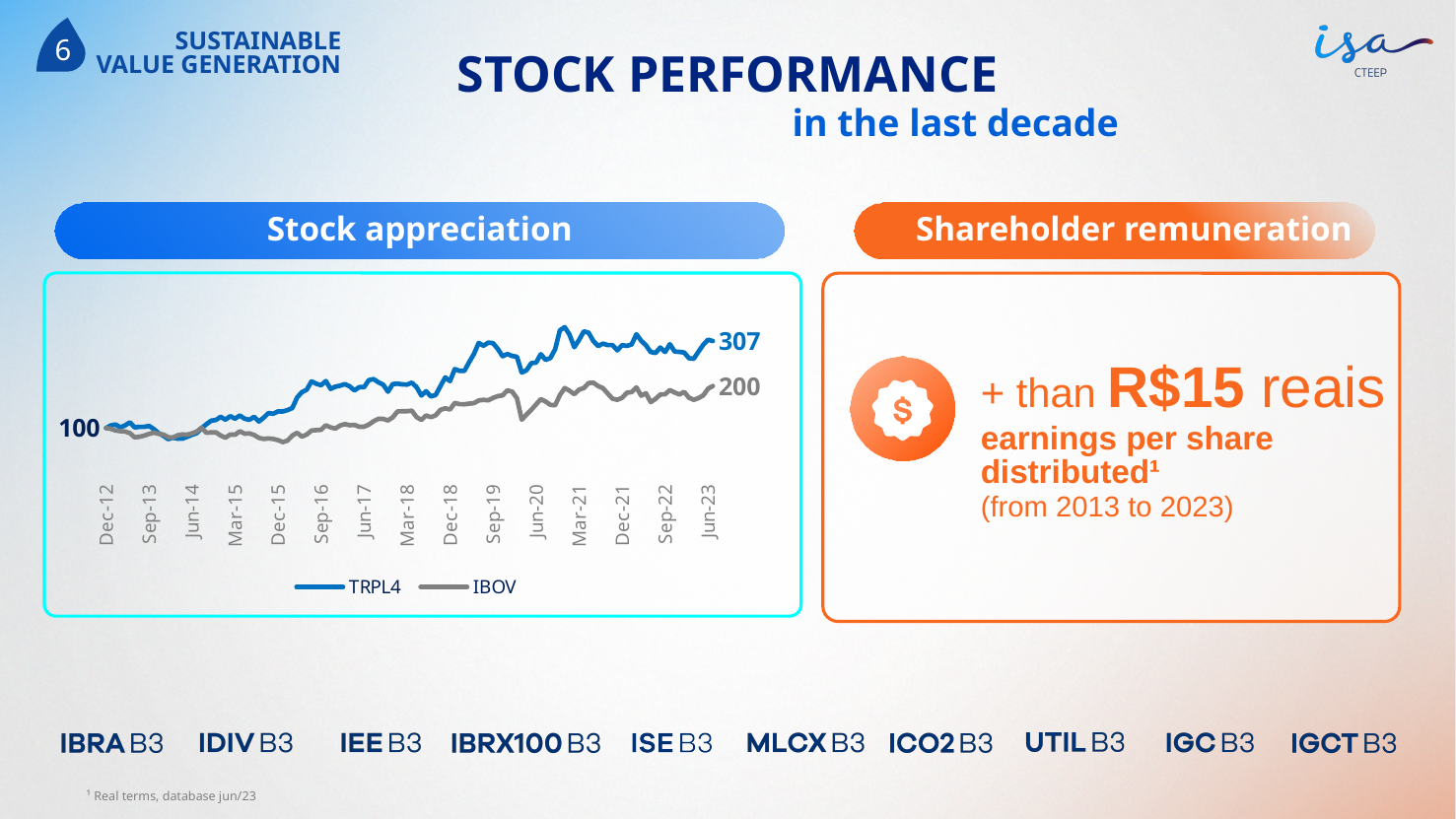
Which series ends higher in Jun-23, TRPL4 or IBOV? TRPL4 What is the starting value of both lines in Dec-12? 100 What is the heading above the line chart? Stock appreciation Which series is drawn in grey in the chart? IBOV What is the final value of the TRPL4 line in Jun-23? 307 What is the final value of the IBOV line in Jun-23? 200 How many date labels are shown on the x axis of the chart? 15 What kind of chart is shown under 'Stock appreciation'? Line chart Do the values of the TRPL4 line generally rise or fall from Dec-12 to Jun-23? Rise What is the difference between the final values of TRPL4 and IBOV in Jun-23? 107 Which series has the highest final value shown on the chart? TRPL4 How many series does the chart legend list? 2